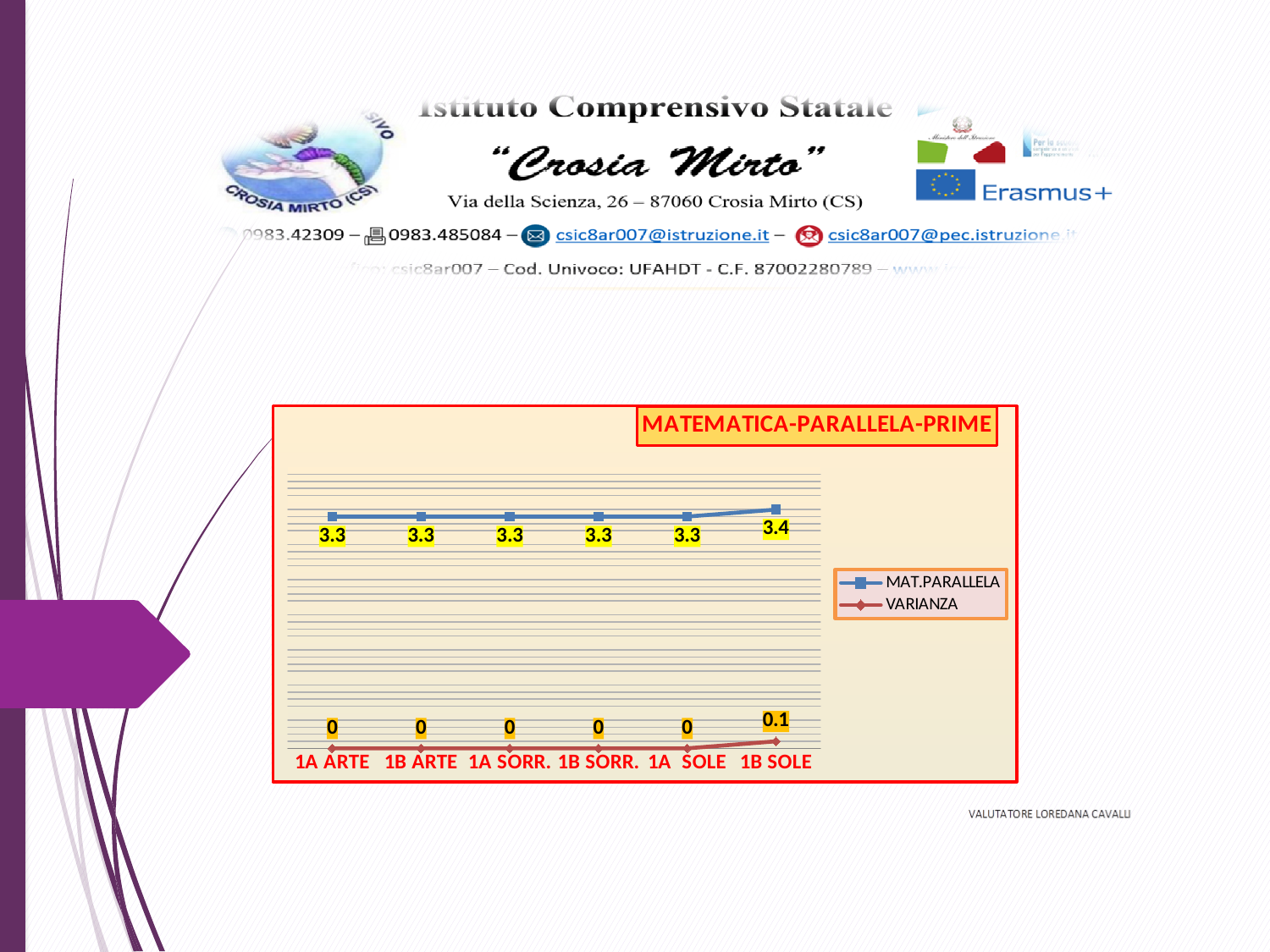
Which category has the highest MAT.PARALLELA value? 1B SOLE What is the MAT.PARALLELA value for 1B SOLE? 3.4 How many categories are shown on the x axis? 6 How many series does the legend list? 2 What is the MAT.PARALLELA value for 1A ARTE? 3.3 What is the difference between the MAT.PARALLELA values for 1B SOLE and 1A SOLE? 0.1 Which category has the highest VARIANZA value? 1B SOLE What is the VARIANZA value for 1A SORR.? 0 What is the title of the chart? MATEMATICA-PARALLELA-PRIME Which is larger, the MAT.PARALLELA value for 1B SOLE or for 1B SORR.? 1B SOLE What is the VARIANZA value for 1B SOLE? 0.1 What kind of chart is shown? Line chart